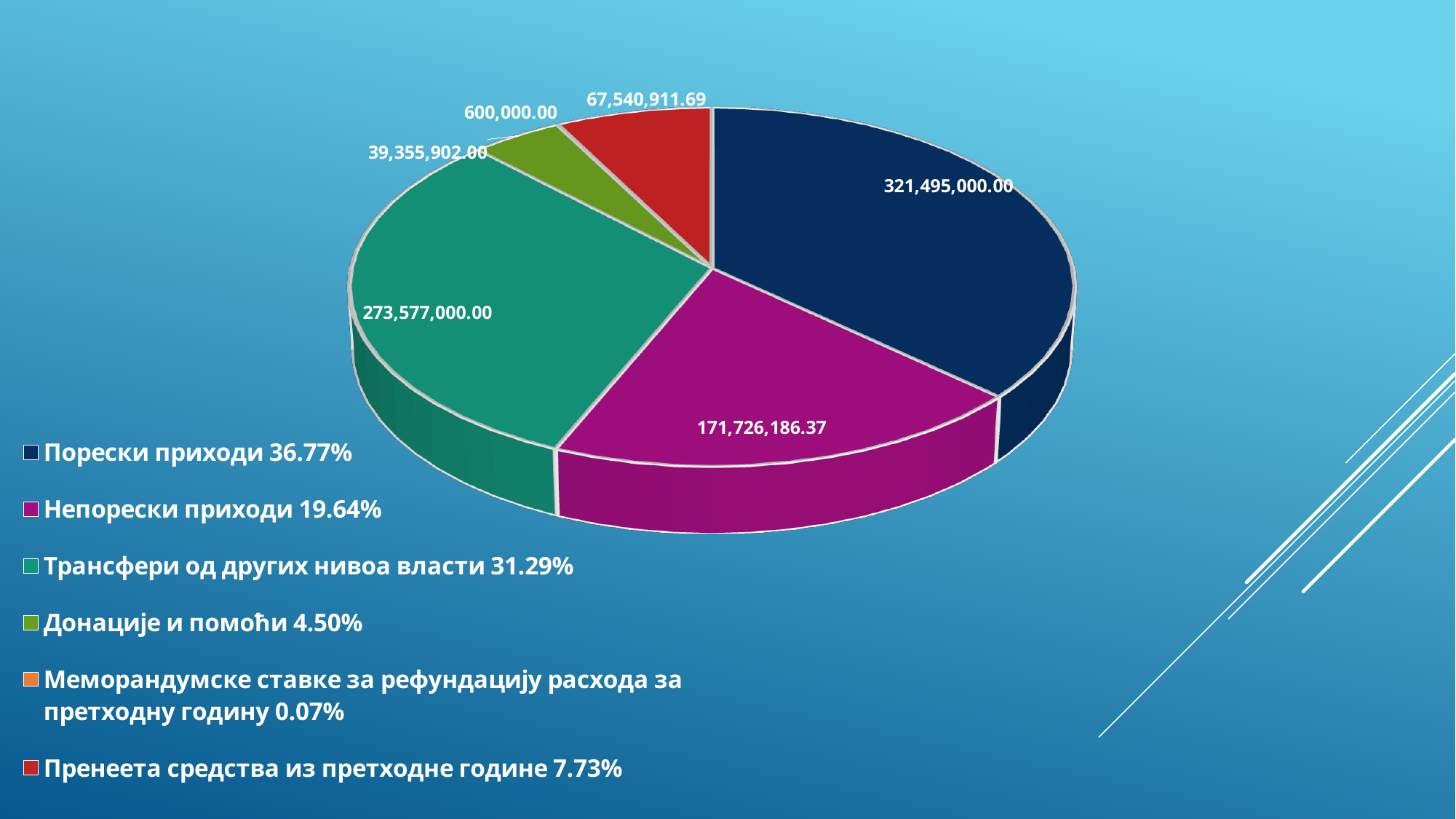
What is the value for Пренеета средства из претходне године? 67,540,911.69 What share of the pie does Трансфери од других нивоа власти represent? 31.29% Which category has the largest slice of the pie? Порески приходи How many categories does the legend list? 6 What type of chart is shown on the slide? Pie chart What is the value for Непорески приходи? 171,726,186.37 Which category has the smallest slice of the pie? Меморандумске ставке за рефундацију расхода за претходну годину Which is larger, the value for Непорески приходи or the value for Трансфери од других нивоа власти? Трансфери од других нивоа власти What is the value for Донације и помоћи? 39,355,902.00 What share of the pie does Донације и помоћи represent? 4.50% What is the value for Порески приходи? 321,495,000.00 What is the value for Трансфери од других нивоа власти? 273,577,000.00